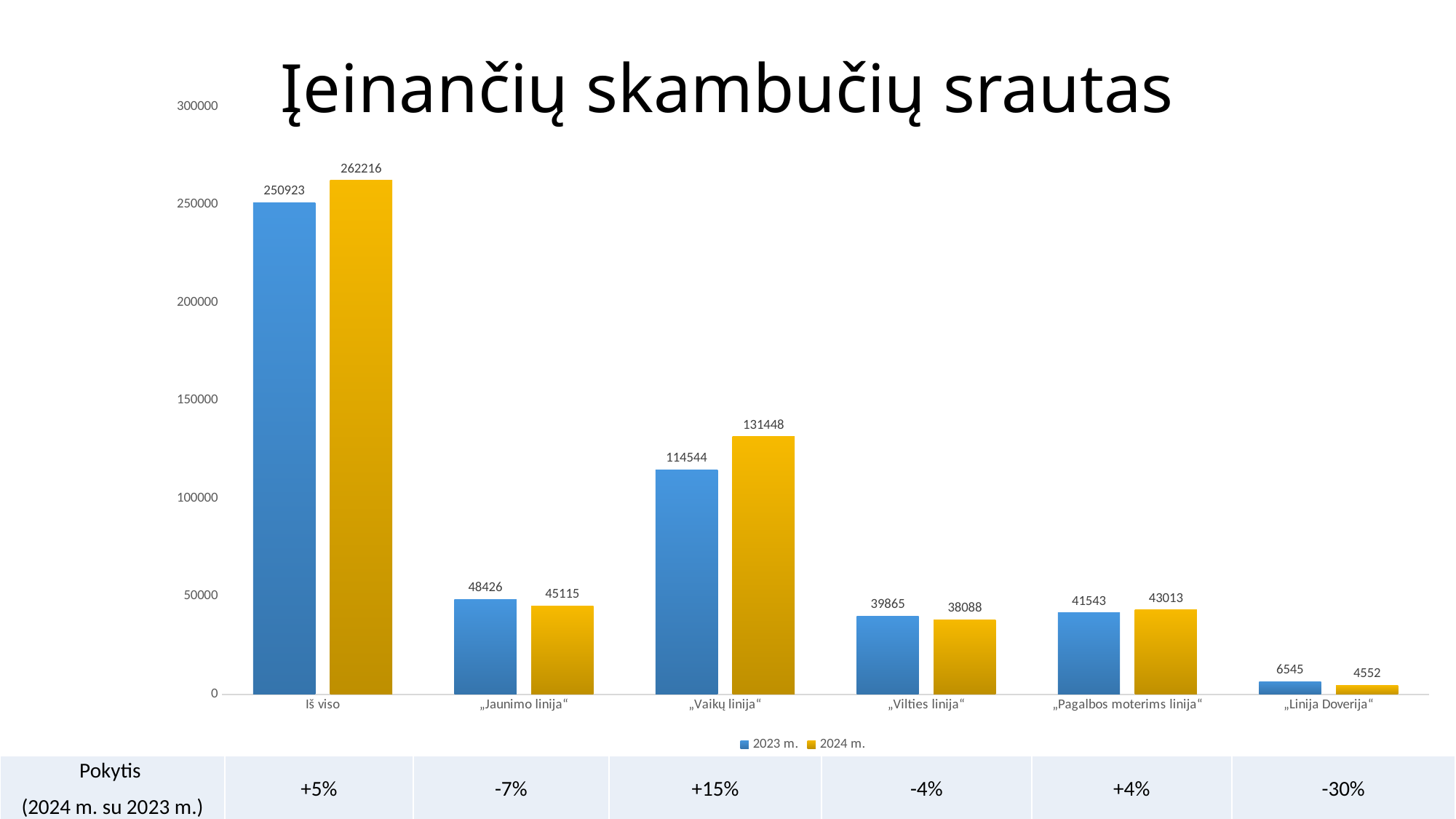
Excluding Iš viso, which category has the highest 2024 m. value? „Vaikų linija“ What type of chart is shown on the slide? Bar chart How many series does the legend list? 2 What is the difference between the 2024 m. and 2023 m. values for „Vaikų linija“? 16904 What is the 2024 m. value for „Vaikų linija“? 131448 What is the difference between the 2023 m. and 2024 m. values for „Jaunimo linija“? 3311 Which category has the lowest 2023 m. value? „Linija Doverija“ For „Vilties linija“, which is larger: the 2023 m. value or the 2024 m. value? 2023 m. How many categories are shown on the x axis? 6 What is the 2024 m. value for „Linija Doverija“? 4552 What is the 2023 m. value for „Jaunimo linija“? 48426 What is the 2023 m. value for Iš viso? 250923